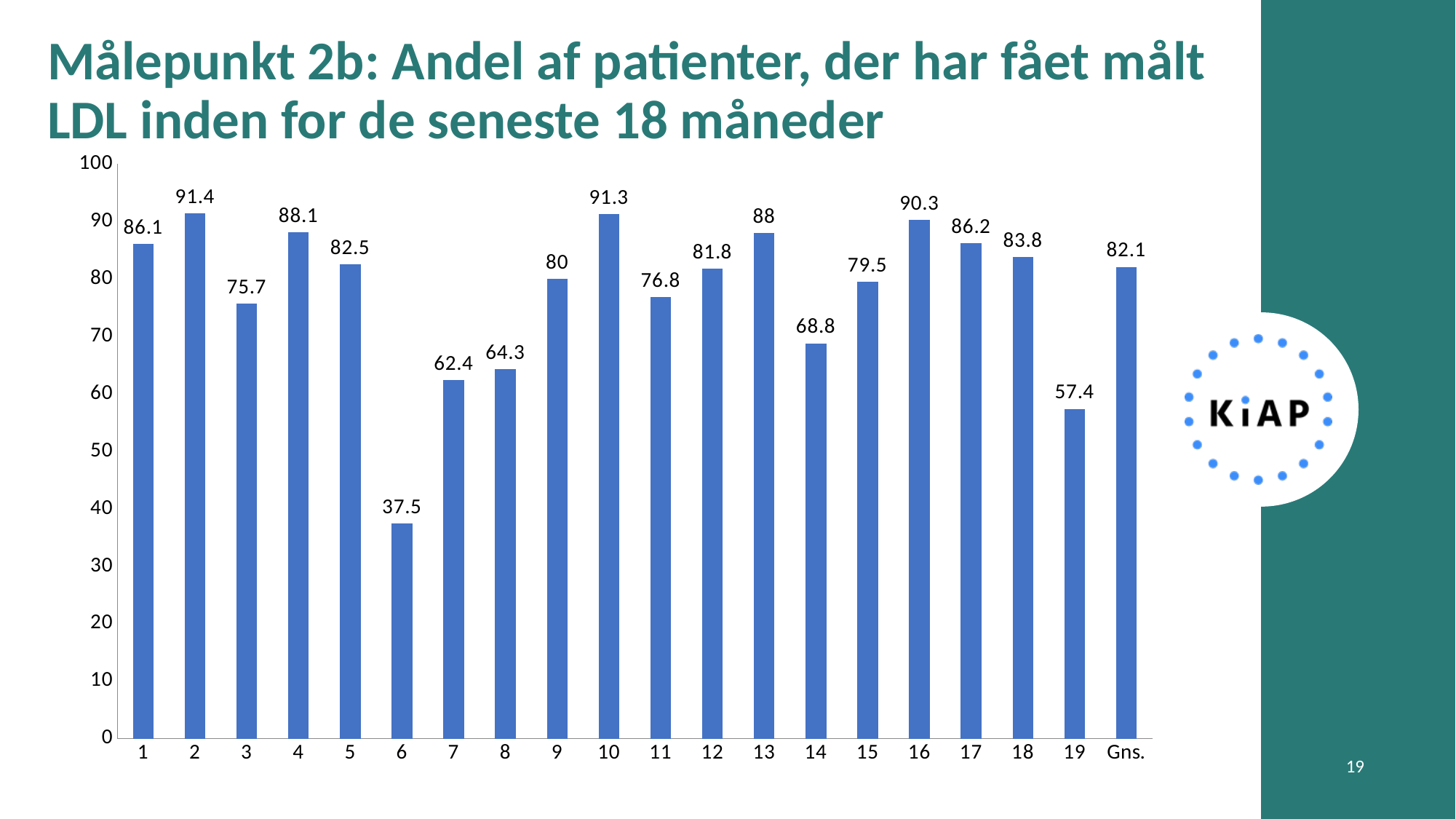
Which category has the lowest value? 6 What is the difference between the values for category 16 and category 14? 21.5 How many bars are shown in the chart? 20 Is the value for category 13 greater or less than 80? greater What is the value for category 10? 91.3 What is the label of the last category on the x axis? Gns. What is the value for category 19? 57.4 What kind of chart is shown on the slide? bar chart Which is larger, the value for category 7 or the value for category 9? 9 What is the difference between the values for category 1 and category 3? 10.4 What is the value for category 6? 37.5 What is the value for Gns.? 82.1